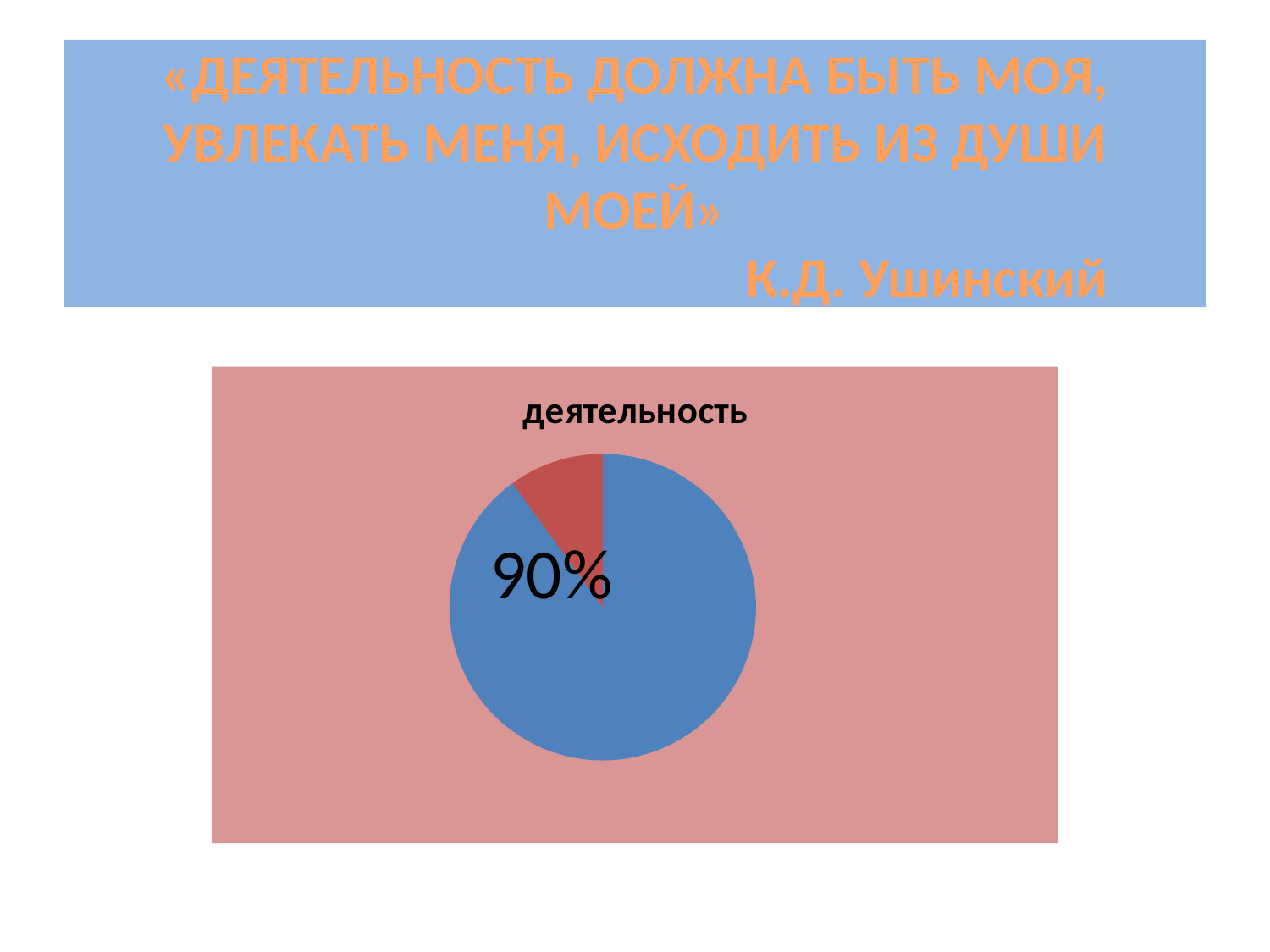
What colour is the largest slice of the pie chart? blue How many slices does the pie chart have? 2 What percentage is printed on the blue slice of the pie chart? 90% What kind of chart is shown on the slide? pie chart Which slice of the pie chart is the smallest? the red slice What share of the pie does the blue slice represent? 90% What is the title of the pie chart? деятельность Which slice of the pie chart is larger, the blue one or the red one? the blue one